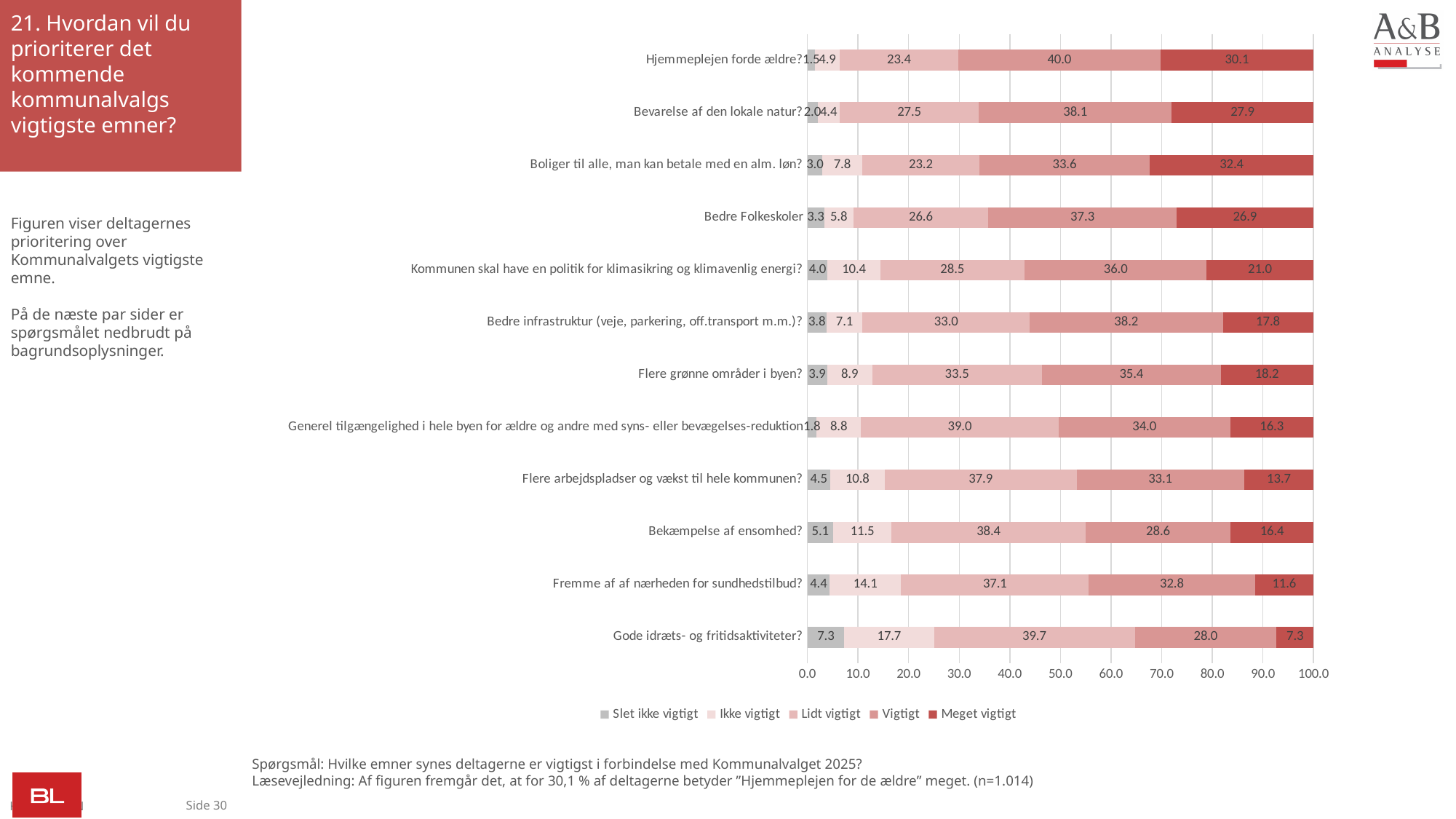
What is the 'Vigtigt' value for 'Bedre Folkeskoler'? 37.3 Which has the larger 'Vigtigt' value: 'Hjemmeplejen forde ældre?' or 'Bekæmpelse af ensomhed?'? Hjemmeplejen forde ældre? How many categories (topics) are plotted in the chart? 12 Which category has the lowest 'Meget vigtigt' value? Gode idræts- og fritidsaktiviteter? What is the 'Ikke vigtigt' value for 'Fremme af af nærheden for sundhedstilbud?'? 14.1 What kind of chart is shown on the slide? Stacked bar chart Which category has the highest 'Slet ikke vigtigt' value? Gode idræts- og fritidsaktiviteter? What is the difference between the 'Lidt vigtigt' value for 'Gode idræts- og fritidsaktiviteter?' and for 'Hjemmeplejen forde ældre?'? 16.3 How many series does the legend list? 5 Which category has the highest 'Meget vigtigt' value? Boliger til alle, man kan betale med en alm. løn? What is the last entry in the chart's legend? Meget vigtigt What is the 'Meget vigtigt' value for 'Boliger til alle, man kan betale med en alm. løn?'? 32.4